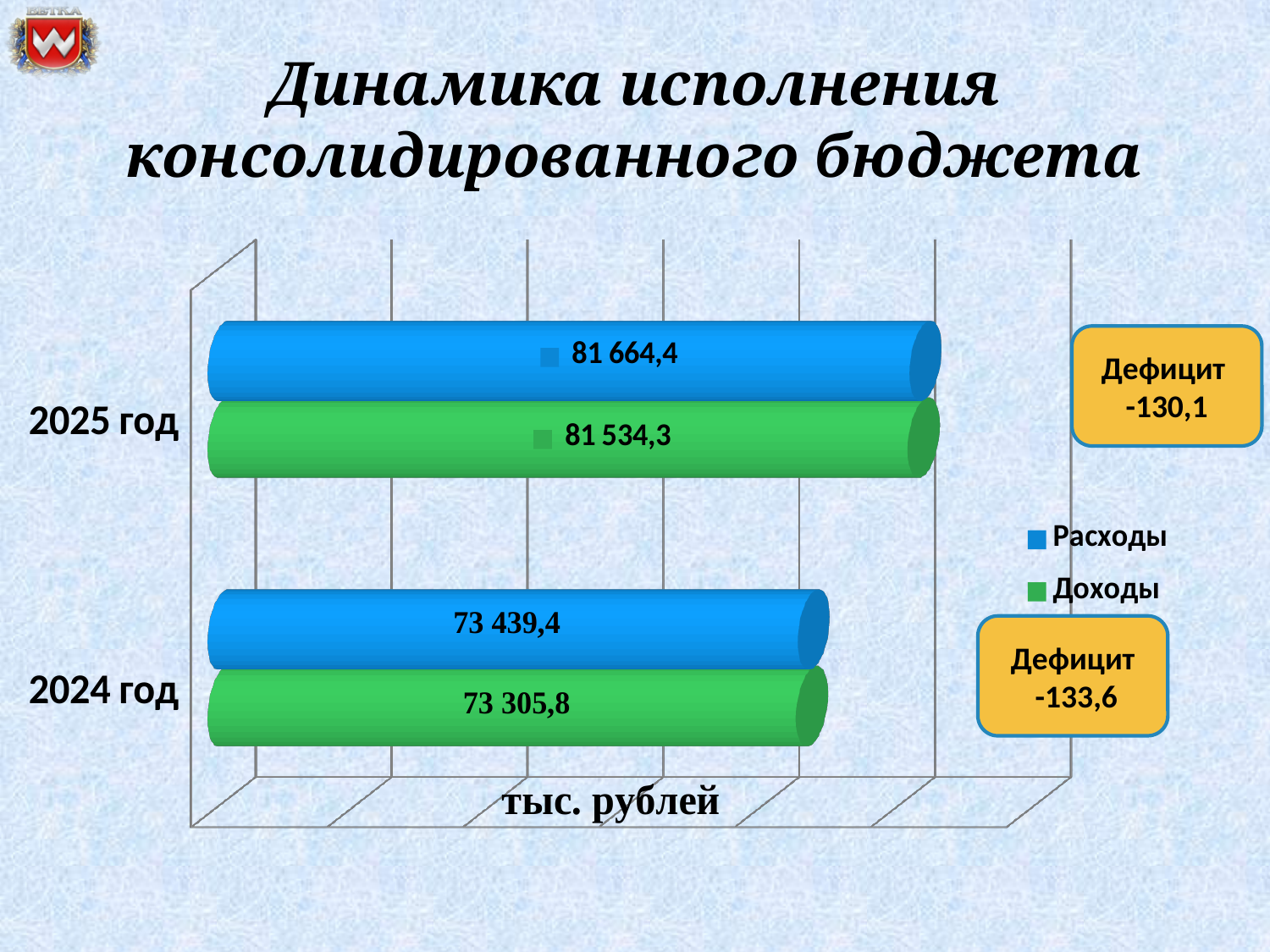
How many series does the legend list? 2 What type of chart is shown on the slide? Bar chart For 2024 год, which is larger: Расходы or Доходы? Расходы Which year has the lower value of Расходы? 2024 год What is the difference between Расходы and Доходы for 2025 год? 130,1 What is the difference between Расходы for 2025 год and Расходы for 2024 год? 8 225,0 What is the value of Доходы for 2025 год? 81 534,3 What is the value of Расходы for 2025 год? 81 664,4 How many years (categories) are shown in the chart? 2 Which year has the higher value of Доходы? 2025 год What is the value of Расходы for 2024 год? 73 439,4 What is the value of Доходы for 2024 год? 73 305,8